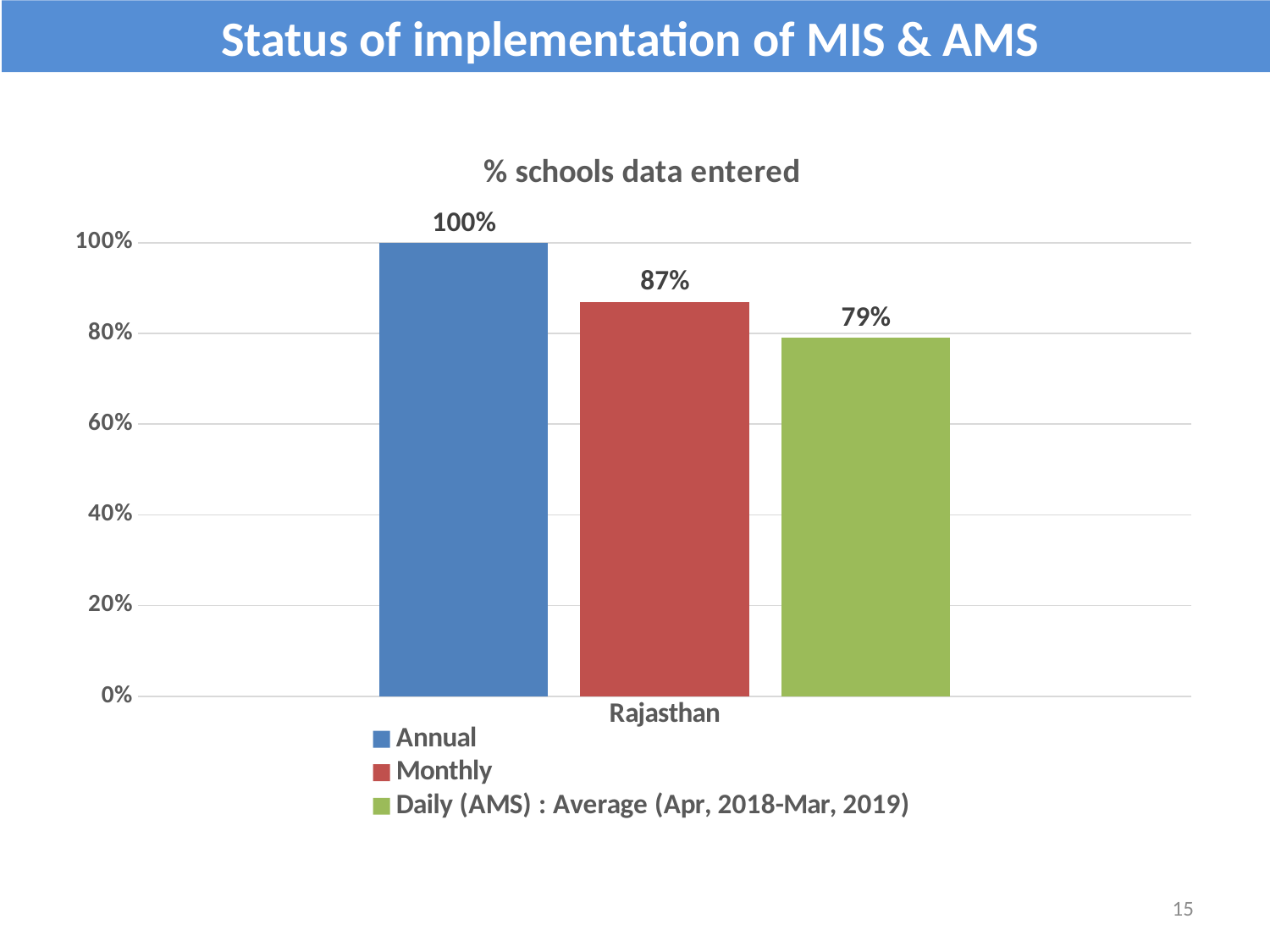
What is the difference between the Monthly and Daily (AMS) values? 8% What is the value for Daily (AMS) : Average (Apr, 2018-Mar, 2019)? 79% Which series has the highest value? Annual What is the value for Monthly in the chart? 87% Is the value for Daily (AMS) greater or less than 80%? less What is the value for Annual in the chart? 100% What is the difference between the Annual and Monthly values? 13% How many series does the legend list? 3 What is the title of the chart? % schools data entered Which is larger, the Monthly value or the Daily (AMS) value? Monthly Which series has the lowest value? Daily (AMS) : Average (Apr, 2018-Mar, 2019) What kind of chart is shown on the slide? Bar chart